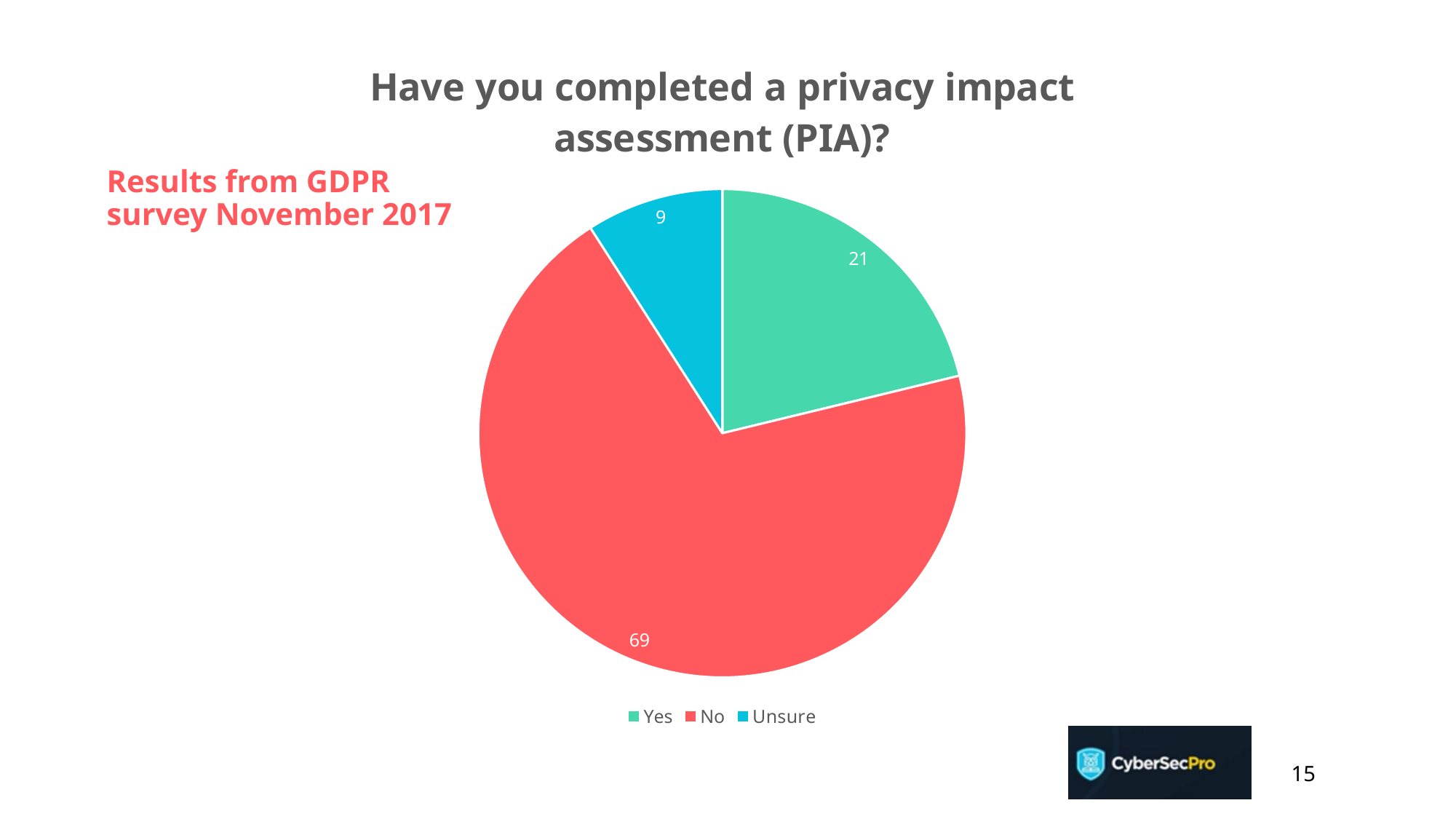
What is the difference between the values for "Yes" and "Unsure"? 12 What kind of chart is shown on the slide? Pie chart What is the value for the "Yes" slice? 21 Which category has the smallest slice? Unsure Which category has the largest slice? No How many slices does the pie chart have? 3 Which is larger, the value for "Yes" or the value for "Unsure"? Yes What is the value for the "Unsure" slice? 9 What is the difference between the values for "No" and "Yes"? 48 How many entries does the legend list? 3 What is the value for the "No" slice? 69 What is the title of the chart? Have you completed a privacy impact assessment (PIA)?